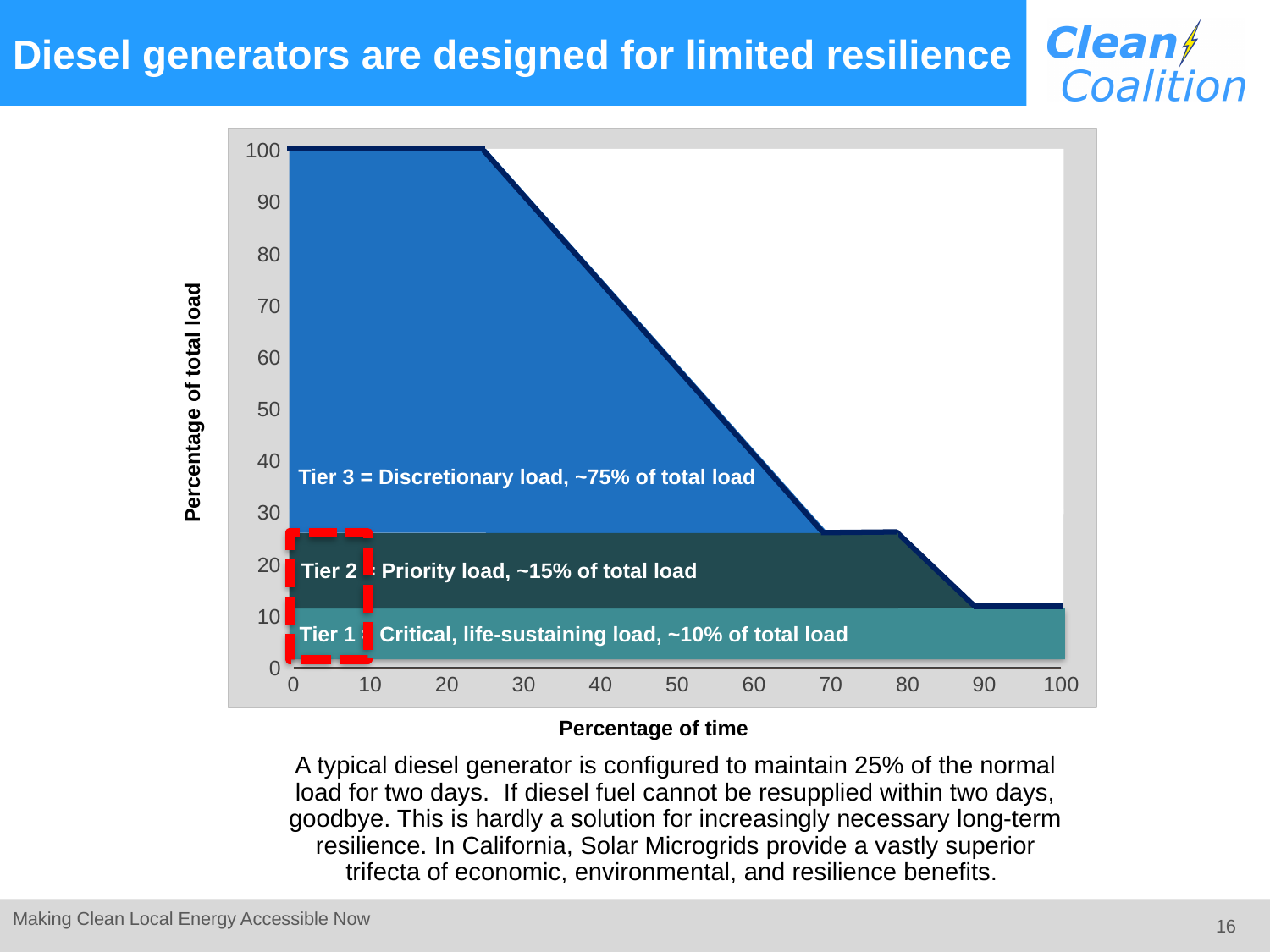
According to the chart label, what share of total load is Tier 1 (Critical, life-sustaining load)? ~10% of total load What is the title of the x axis? Percentage of time Do the values rise or fall as the percentage of time increases along the x axis? fall What kind of chart is shown on the slide? area chart Is the percentage of total load at 10% of time greater or less than 90? greater What is the title of the y axis? Percentage of total load Is the percentage of total load at 50% of time greater or less than 50? greater Is the percentage of total load at 60% of time greater or less than 50? less According to the chart label, what share of total load is Tier 3 (Discretionary load)? ~75% of total load What is the percentage of total load at 0% of time? 100 How many load tiers are labelled on the chart? 3